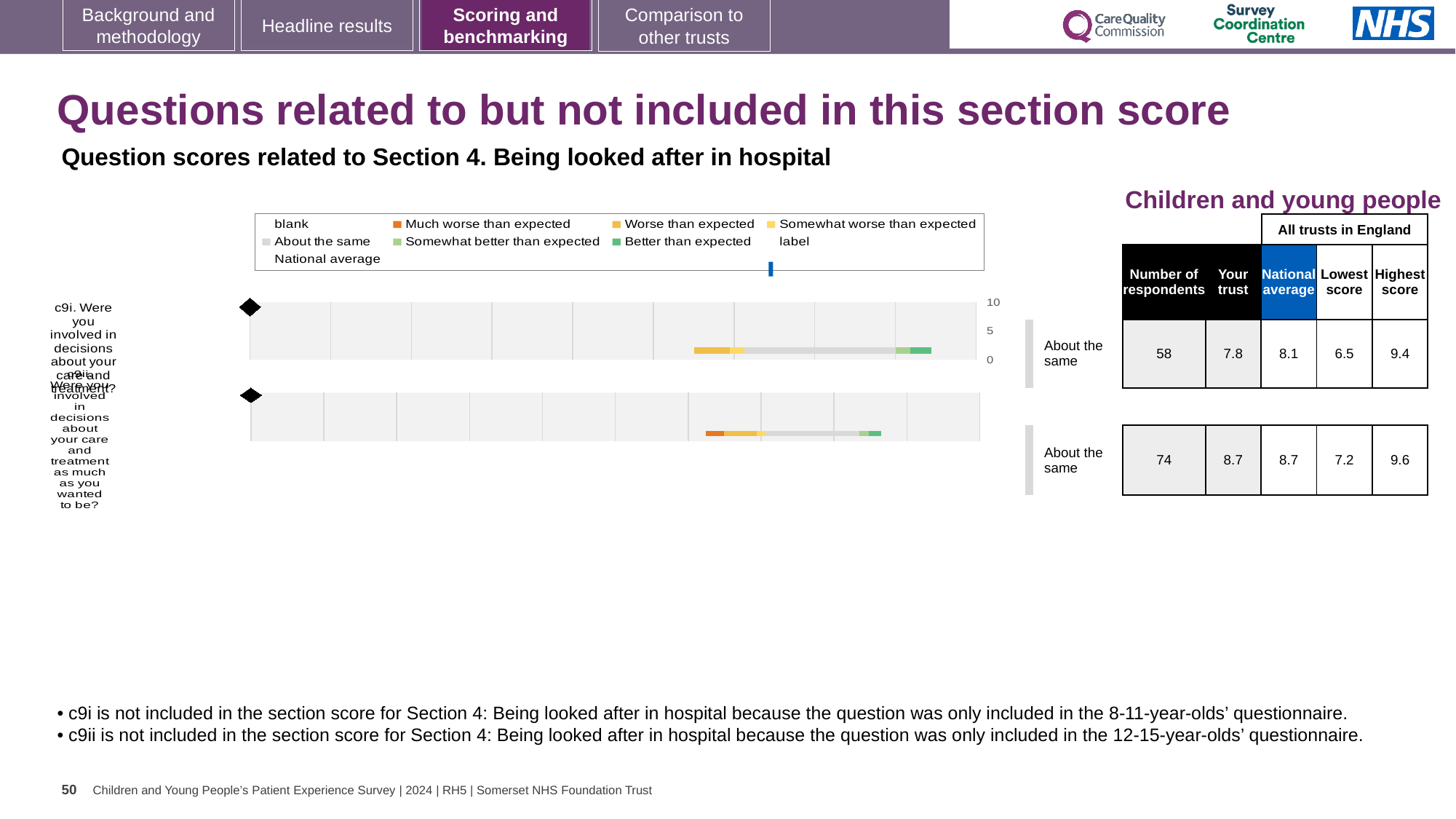
What is the difference between the highest score (9.4) and the lowest score (6.5) across all trusts for c9i? 2.9 Which question had more respondents, c9i or c9ii? c9ii What colour does the legend use for 'Better than expected'? green What is the 'Your trust' score for c9i (Were you involved in decisions about your care and treatment?)? 7.8 How many questions (rows) are plotted in the chart area? 2 What benchmark category is shown for both c9i and c9ii? About the same What is the 'Your trust' score for c9ii (Were you involved in decisions about your care and treatment as much as you wanted to be?)? 8.7 What kind of chart is used to show the question scores for c9i and c9ii? bar chart What is the maximum value shown on the chart's score axis? 10 What is the national average score for c9i? 8.1 How many respondents answered c9ii? 74 What is the highest score across all trusts in England for c9ii? 9.6